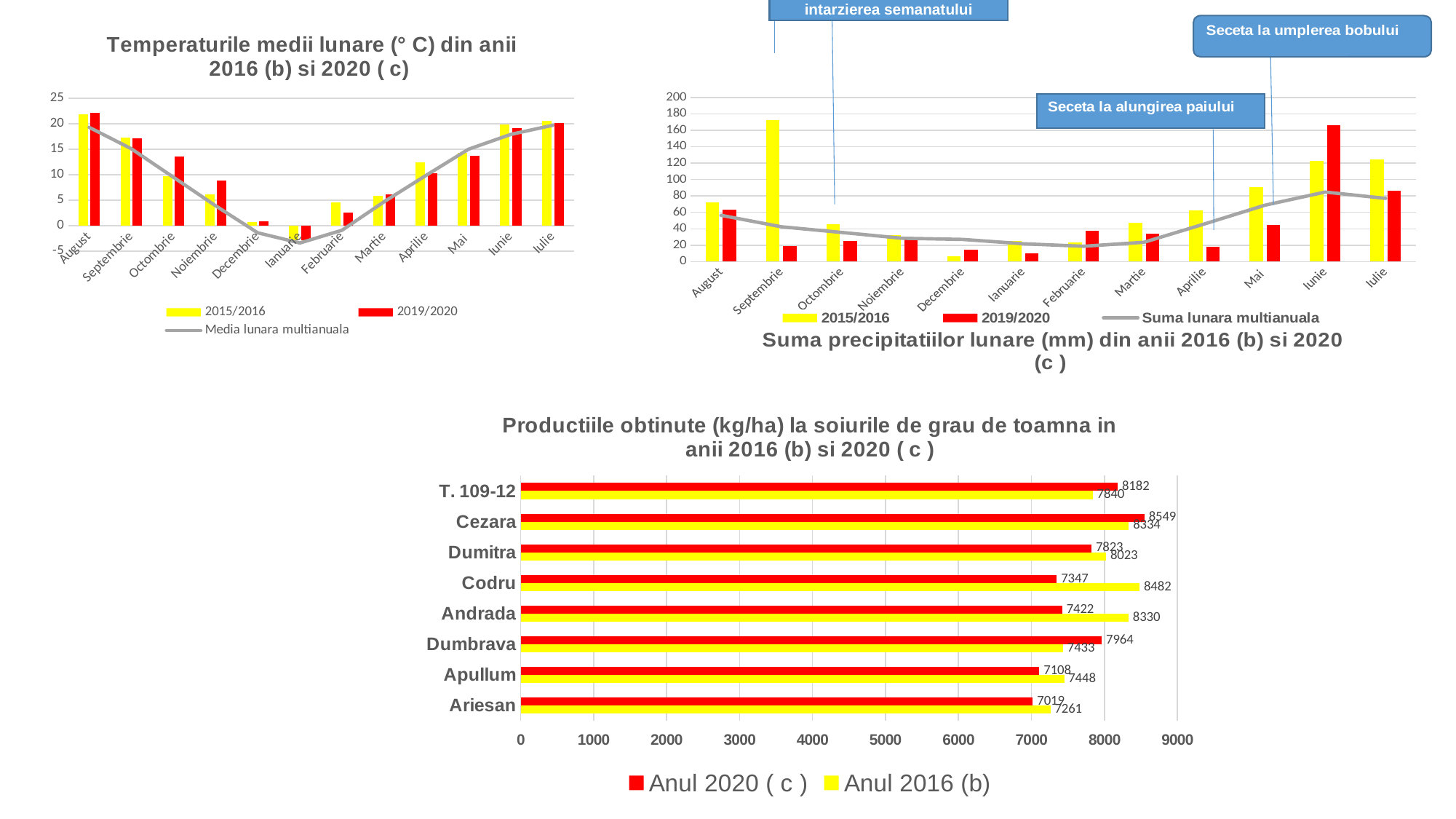
In the chart 'Productiile obtinute (kg/ha) la soiurile de grau de toamna', what is the value for Codru in Anul 2016 (b)? 8482 In the chart 'Productiile obtinute (kg/ha) la soiurile de grau de toamna', what is the difference between the Anul 2020 ( c ) and Anul 2016 (b) values for Dumbrava? 531 In the chart 'Productiile obtinute (kg/ha) la soiurile de grau de toamna', which is larger for Andrada: Anul 2020 ( c ) or Anul 2016 (b)? Anul 2016 (b) In the chart 'Temperaturile medii lunare (° C)', which month has the lowest value for the 2015/2016 series? Ianuarie In the chart 'Temperaturile medii lunare (° C)', is the 2019/2020 value for August greater or less than 20? greater In the chart 'Productiile obtinute (kg/ha) la soiurile de grau de toamna', what is the value for Cezara in Anul 2020 ( c )? 8549 How many series does the legend of the chart 'Suma precipitatiilor lunare (mm)' list? 3 What kind of chart is 'Productiile obtinute (kg/ha) la soiurile de grau de toamna'? Bar chart How many wheat varieties are shown in the chart 'Productiile obtinute (kg/ha) la soiurile de grau de toamna'? 8 In the chart 'Productiile obtinute (kg/ha) la soiurile de grau de toamna', which variety has the highest value for Anul 2016 (b)? Codru In the chart 'Productiile obtinute (kg/ha) la soiurile de grau de toamna', which variety has the lowest value for Anul 2020 ( c )? Ariesan In the chart 'Suma precipitatiilor lunare (mm)', is the 2015/2016 value for Septembrie greater or less than 160? greater